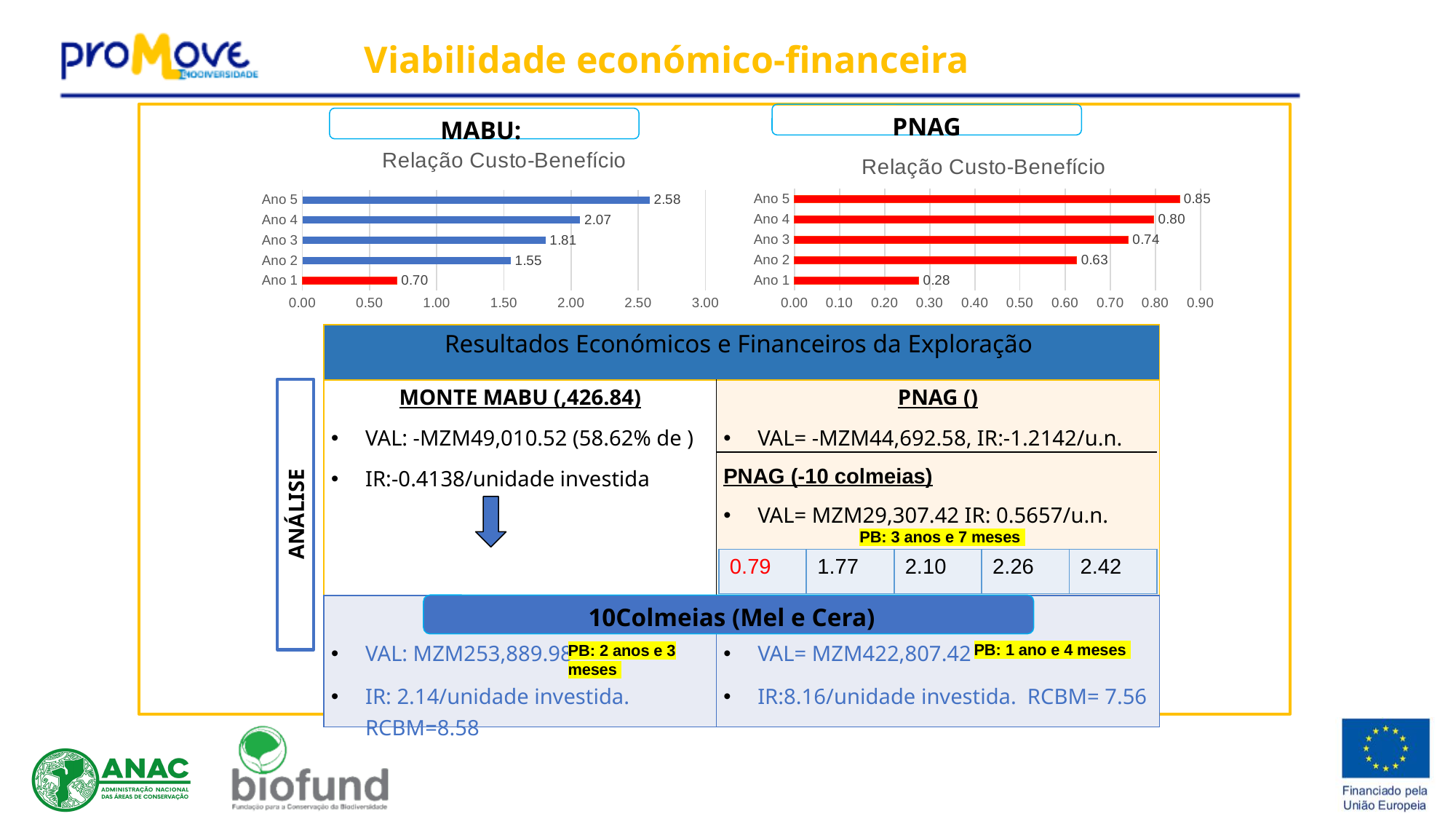
In the MABU chart on the left, which is larger, the value for Ano 3 or the value for Ano 2? Ano 3 In the PNAG chart on the right, which year has the highest value? Ano 5 How many years (categories) are shown in the MABU chart on the left? 5 What kind of chart is the PNAG chart on the right? Bar chart In the PNAG chart on the right, do the values rise or fall from Ano 1 to Ano 5? Rise In the MABU chart on the left, what is the difference between the values for Ano 5 and Ano 1? 1.88 In the PNAG chart on the right, what is the value for Ano 1? 0.28 In the PNAG chart on the right, is the value for Ano 3 greater or less than 0.70? greater In the MABU chart on the left, which year has the lowest value? Ano 1 In the MABU chart on the left, what is the value for Ano 5? 2.58 In the PNAG chart on the right, what is the difference between the values for Ano 4 and Ano 2? 0.17 What is the title of the MABU chart on the left? Relação Custo-Benefício